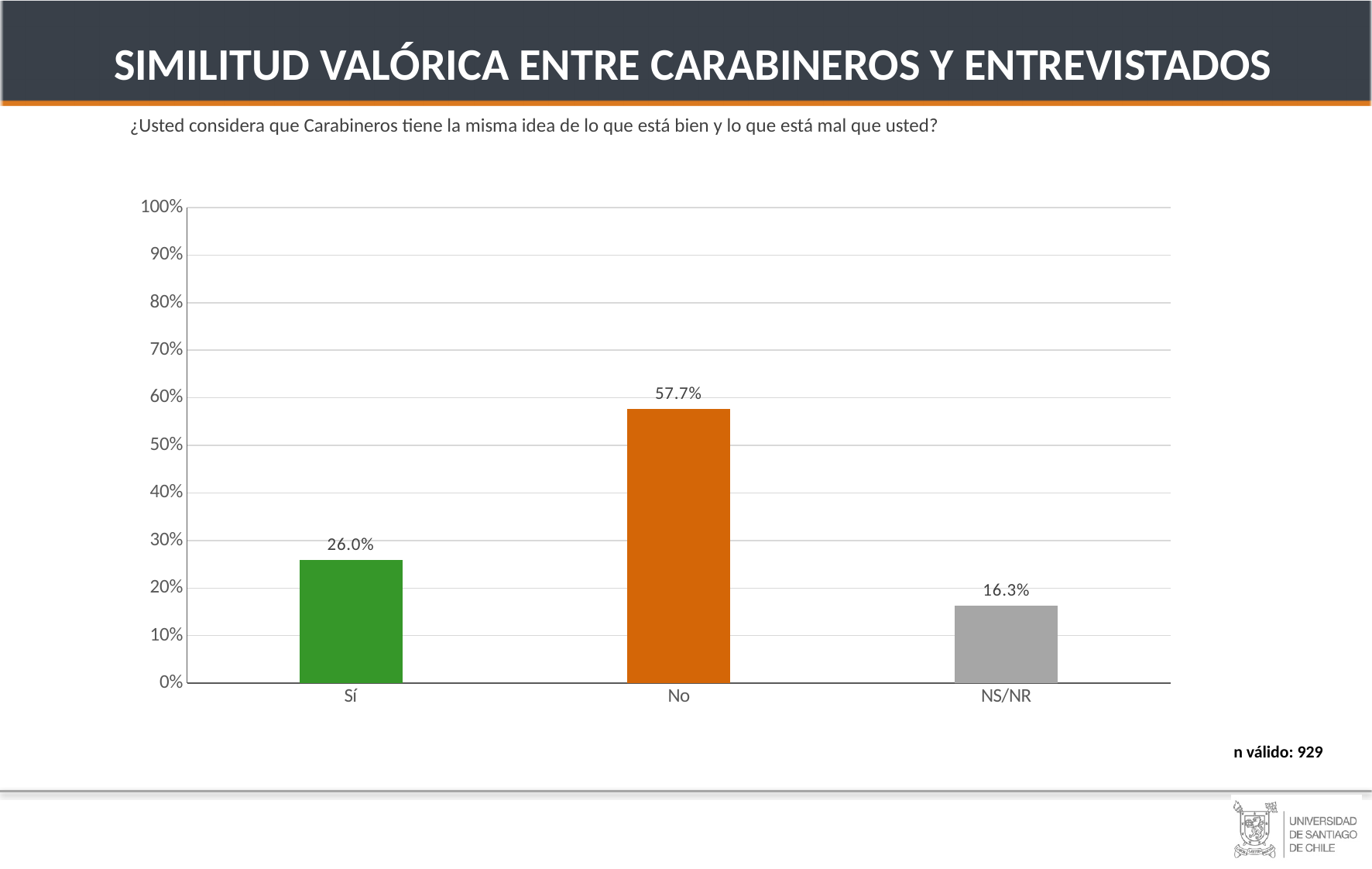
What is the difference between the values for "Sí" and "NS/NR"? 9.7% What colour is the bar for "No"? orange What is the difference between the values for "No" and "Sí"? 31.7% What is the value for "Sí"? 26.0% Which category has the lowest value? NS/NR Is the value for "No" greater or less than 50%? greater Which is larger, the value for "Sí" or the value for "NS/NR"? Sí What kind of chart is shown on the slide? bar chart How many categories are shown on the x axis? 3 What is the value for "No"? 57.7% What is the value for "NS/NR"? 16.3% Which category has the highest value? No